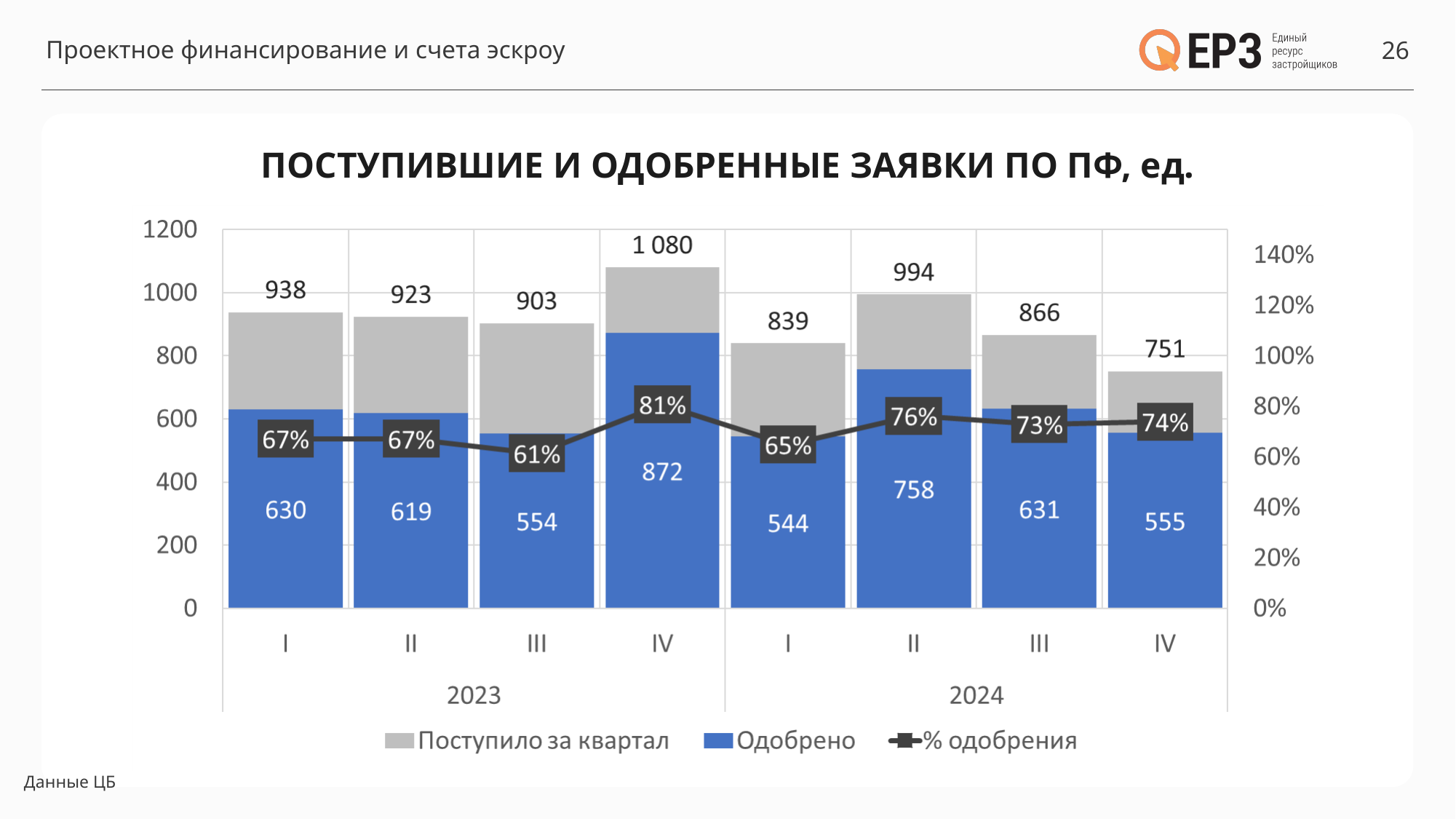
What is the "% одобрения" value for quarter III of 2023? 61% In which quarter is the "Поступило за квартал" value the highest? IV 2023 What type of chart is shown on the slide? Bar chart with a line What is the value of "Одобрено" for quarter IV of 2023? 872 What is the value of "Поступило за квартал" for quarter II of 2024? 994 What is the title of the chart? ПОСТУПИВШИЕ И ОДОБРЕННЫЕ ЗАЯВКИ ПО ПФ, ед. What is the difference between "Поступило за квартал" and "Одобрено" in quarter IV of 2024? 196 In which quarter is the "Одобрено" value the lowest? I 2024 Does the "% одобрения" line rise or fall from quarter I 2024 to quarter II 2024? Rise How many series does the legend list? 3 Which is larger: the "Одобрено" value for quarter I of 2023 or for quarter III of 2024? III 2024 How many quarters are plotted on the x axis? 8